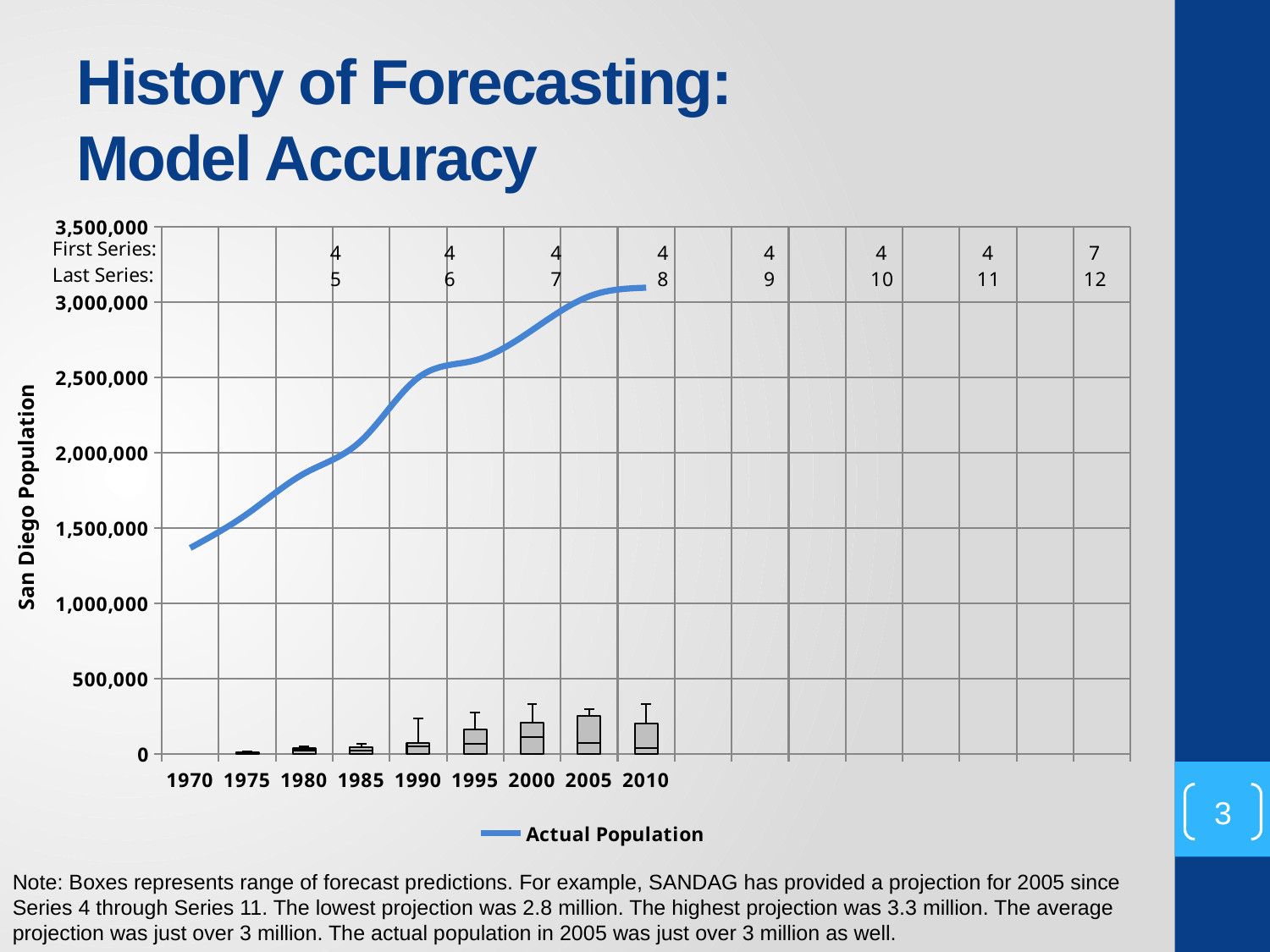
Does the Actual Population line rise or fall from 1970 to 2010? rise What kind of chart is shown on the slide? combination bar and line chart Is the Actual Population for 2010 greater or less than 3,000,000? greater In which year is the Actual Population highest? 2010 How many years are labelled on the x axis? 9 What is the label on the vertical axis? San Diego Population How many series does the legend list? 1 Is the Actual Population for 1970 greater or less than 1,500,000? less In which year is the Actual Population lowest? 1970 What is the name of the series shown in the legend? Actual Population Which year has the larger Actual Population, 1975 or 1995? 1995